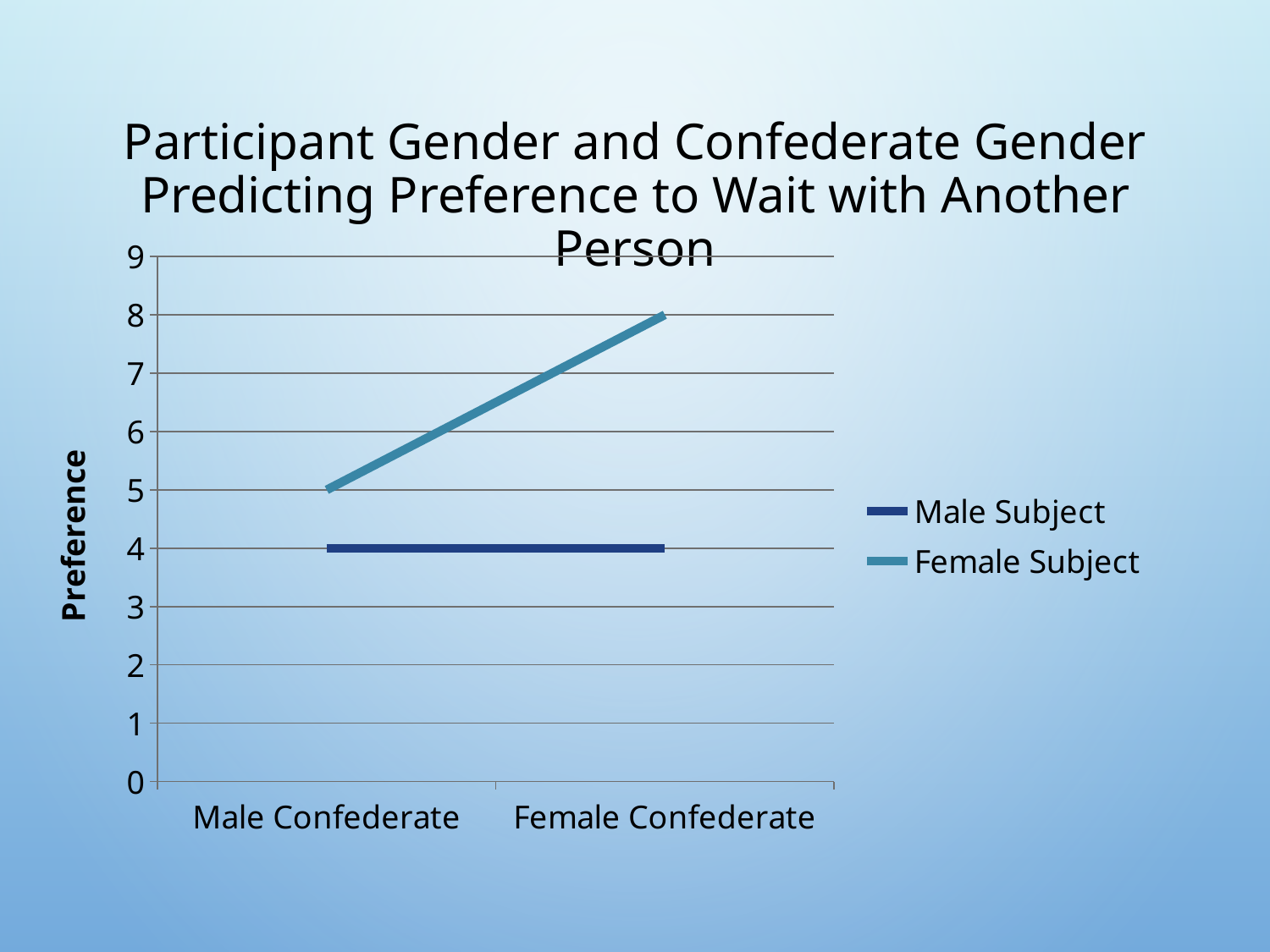
How many categories are shown on the x axis? 2 What is the Preference value for Female Subject at Female Confederate? 8 Which series has the higher value at Female Confederate, Male Subject or Female Subject? Female Subject What is the Preference value for Female Subject at Male Confederate? 5 What is the label of the vertical axis? Preference What is the difference between the Female Subject values at Female Confederate and Male Confederate? 3 Does the Female Subject line rise or fall from Male Confederate to Female Confederate? rise What is the Preference value for Male Subject at Female Confederate? 4 What is the Preference value for Male Subject at Male Confederate? 4 How many series does the legend list? 2 Does the Male Subject line rise, fall, or stay flat from Male Confederate to Female Confederate? stay flat What kind of chart is shown on the slide? line chart